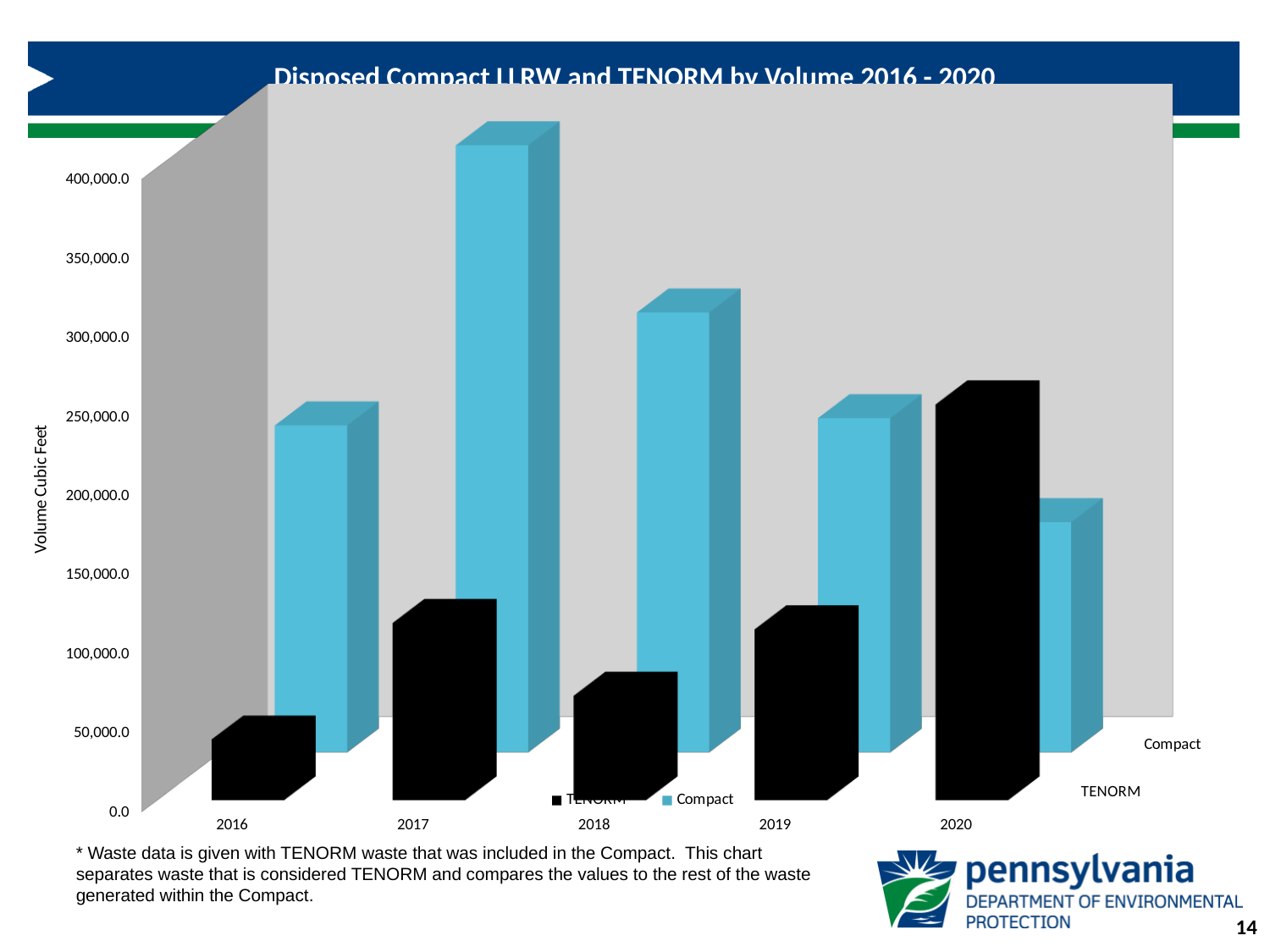
Which year has the highest Compact volume? 2017 How many series does the chart's legend list? 2 In 2020, which is larger, the TENORM value or the Compact value? TENORM What kind of chart is shown on the slide? bar chart Which year has the lowest Compact volume? 2020 Is the Compact value for 2020 greater or less than 200,000.0? less Which year has the lowest TENORM volume? 2016 What is the label on the vertical axis of the chart? Volume Cubic Feet Which year has the highest TENORM volume? 2020 Is the TENORM value for 2018 greater or less than 100,000.0? less How many years are shown on the x axis of the chart? 5